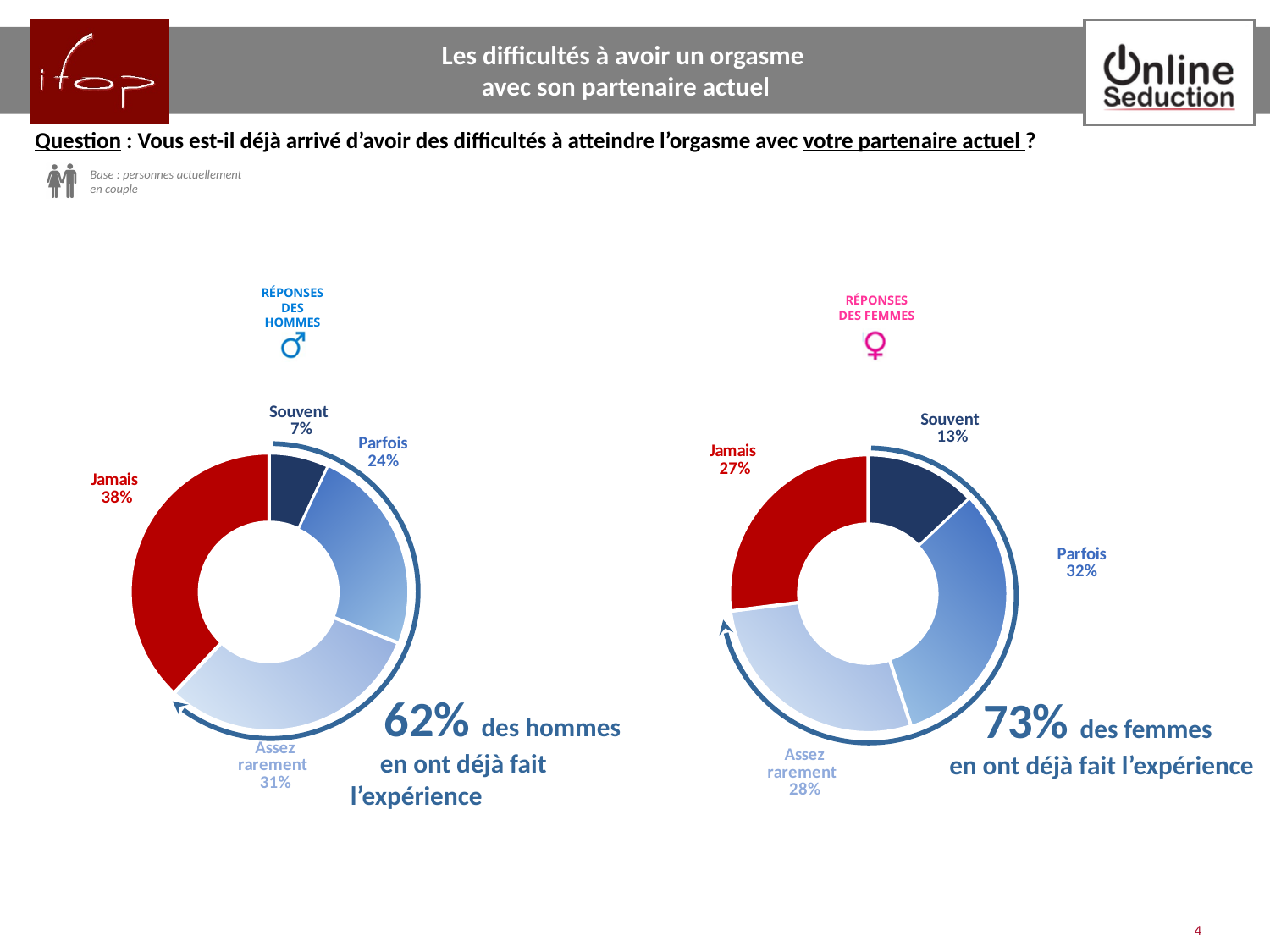
In the 'Réponses des femmes' chart, which response has the smallest share? Souvent In the 'Réponses des hommes' chart, what percentage answered 'Souvent'? 7% In the 'Réponses des femmes' chart, what percentage answered 'Assez rarement'? 28% In the 'Réponses des hommes' chart, which response has the largest share? Jamais How many response categories does each donut chart show? 4 What is the difference between the 'Jamais' share in the men's chart and the 'Jamais' share in the women's chart? 11 percentage points In the 'Réponses des hommes' chart, what colour is the 'Jamais' slice? Red What type of chart is used to show the men's responses? Donut (pie) chart Which is larger: the 'Souvent' share for men or the 'Souvent' share for women? Women (13%) In the 'Réponses des hommes' chart, what percentage answered 'Jamais'? 38% In the 'Réponses des femmes' chart, what percentage answered 'Parfois'? 32% In the 'Réponses des femmes' chart, which response has the largest share? Parfois